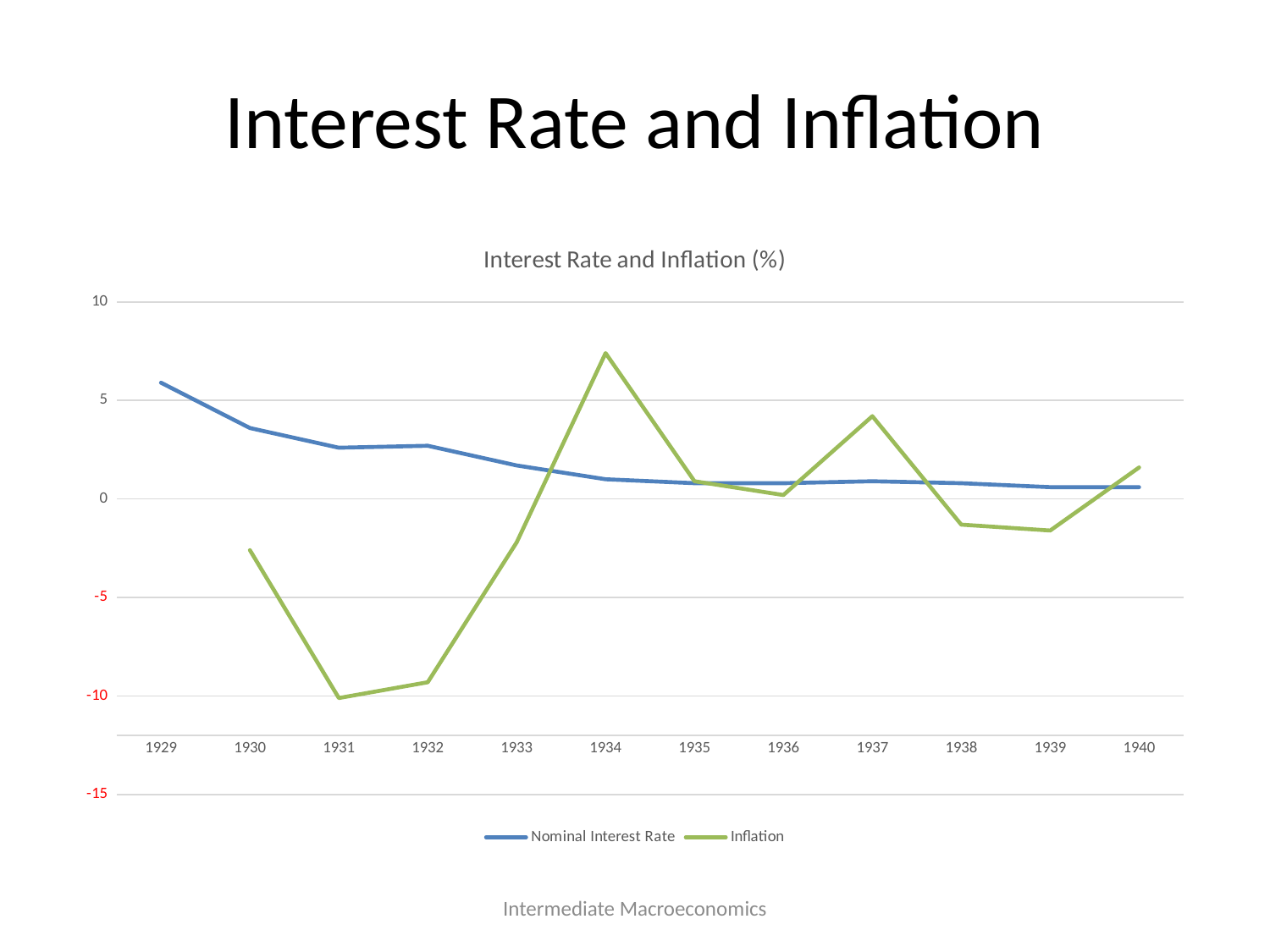
Does the Nominal Interest Rate generally rise or fall from 1929 to 1940? fall What is the title of the chart? Interest Rate and Inflation (%) What kind of chart is shown on the slide? line chart Is the Inflation value for 1931 greater or less than -5? less In 1934, which series has the larger value, Nominal Interest Rate or Inflation? Inflation Is the Nominal Interest Rate value for 1929 greater or less than 5? greater Is the Inflation value for 1934 greater or less than 5? greater How many series does the legend list? 2 In which year does Inflation reach its highest value? 1934 In which year does Inflation reach its lowest value? 1931 How many years are plotted along the x axis? 12